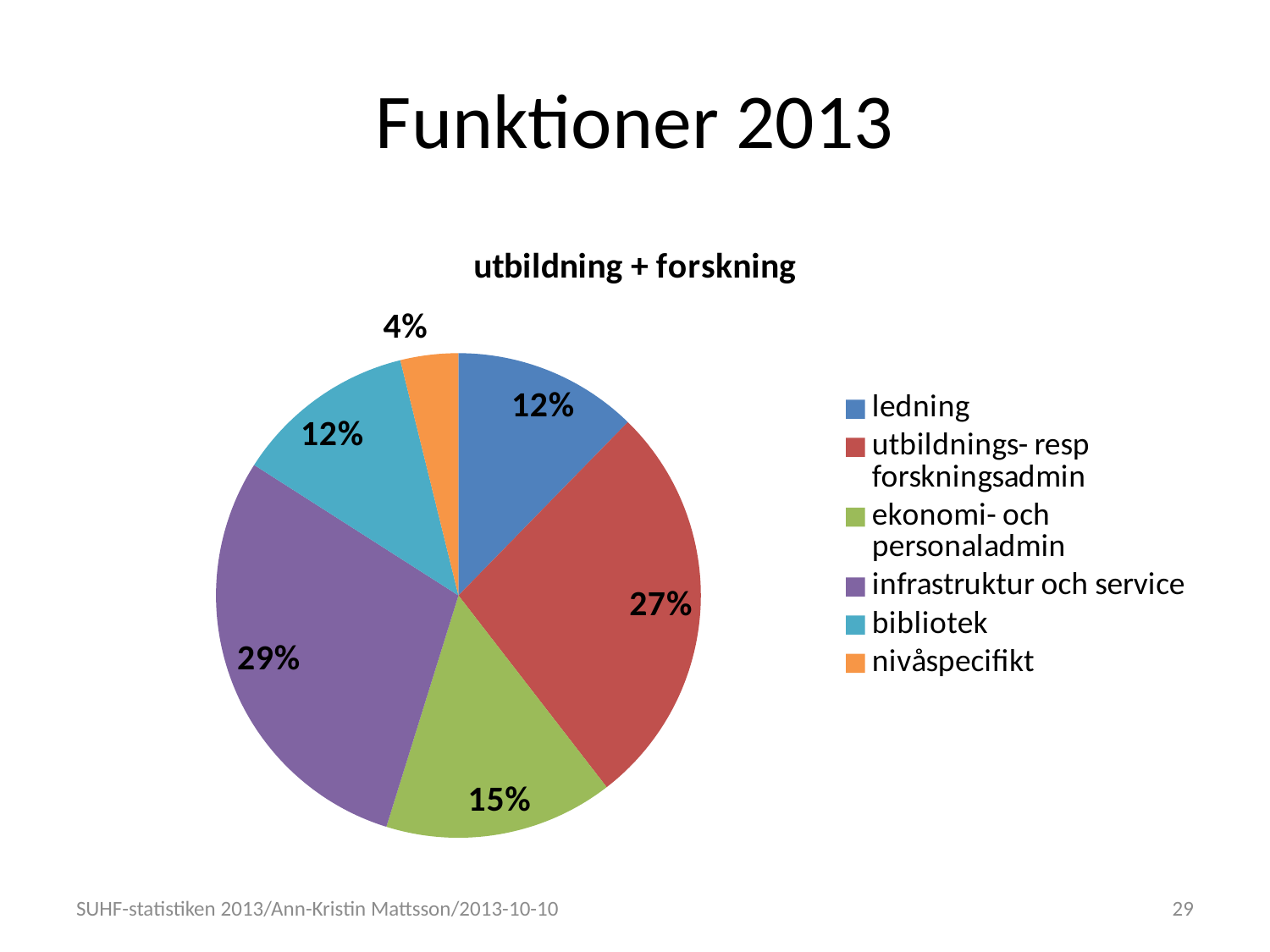
What share of the pie does 'nivåspecifikt' have? 4% What kind of chart is shown on the slide? pie chart What is the difference in percentage points between 'infrastruktur och service' and 'ekonomi- och personaladmin'? 14 percentage points What is the chart's title? utbildning + forskning Which category has the largest share of the pie? infrastruktur och service What share of the pie does 'utbildnings- resp forskningsadmin' have? 27% What share of the pie does 'infrastruktur och service' have? 29% Which category has the smallest share of the pie? nivåspecifikt How many categories does the legend list? 6 Which is larger, the share for 'bibliotek' or the share for 'utbildnings- resp forskningsadmin'? utbildnings- resp forskningsadmin